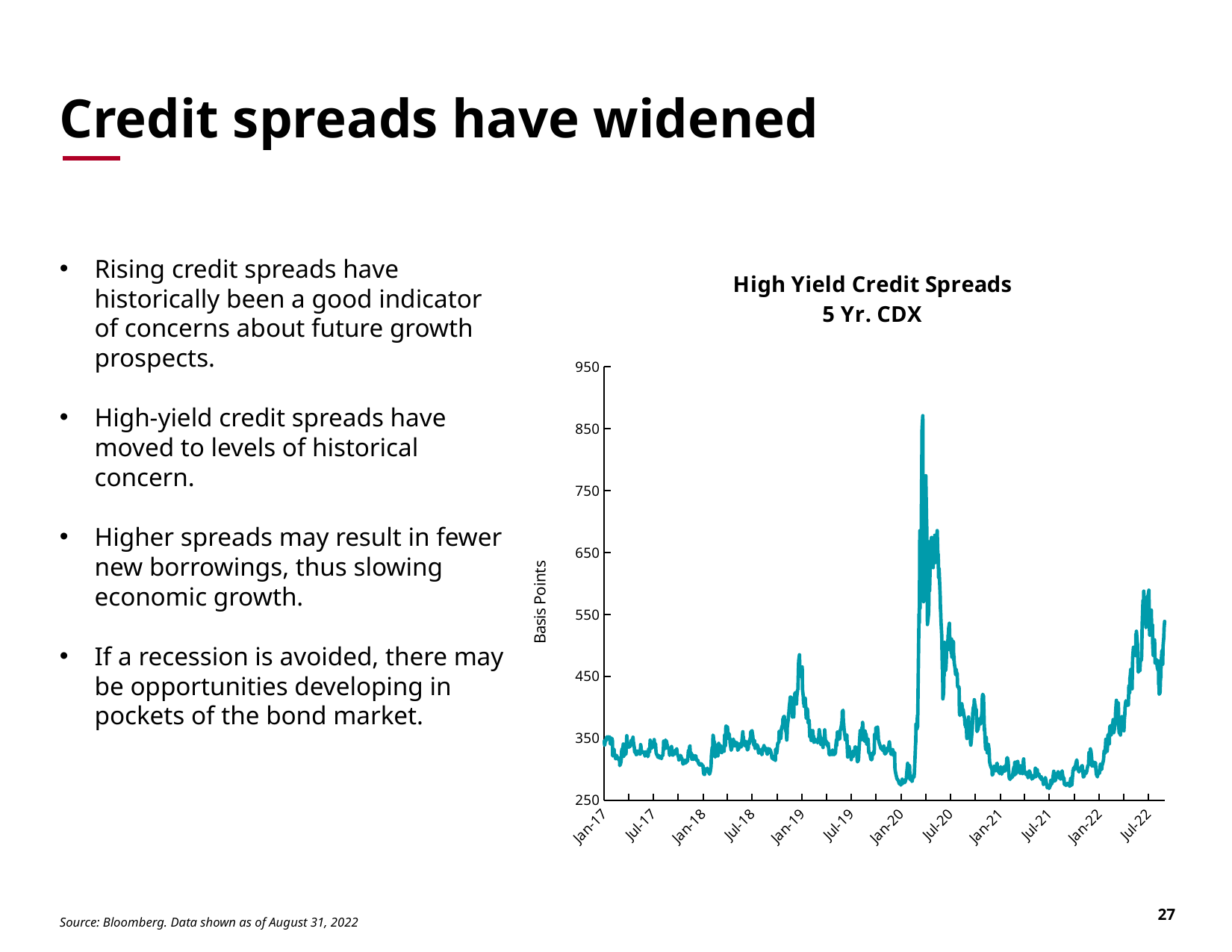
What is the label on the vertical axis of the chart? Basis Points How many lines (series) are plotted on the chart? 1 Is the peak value around Jan-19 greater or less than 450? greater Does the line generally rise or fall between Jul-20 and Jan-21? fall What kind of chart is shown on the slide? line chart Is the peak value of the line in early 2020 greater or less than 750? greater Is the highest value reached in 2022 greater or less than 550? greater What is the title of the chart? High Yield Credit Spreads 5 Yr. CDX Does the line generally rise or fall between Jan-21 and Jul-22? rise In which year does the line reach its highest point on the chart? 2020